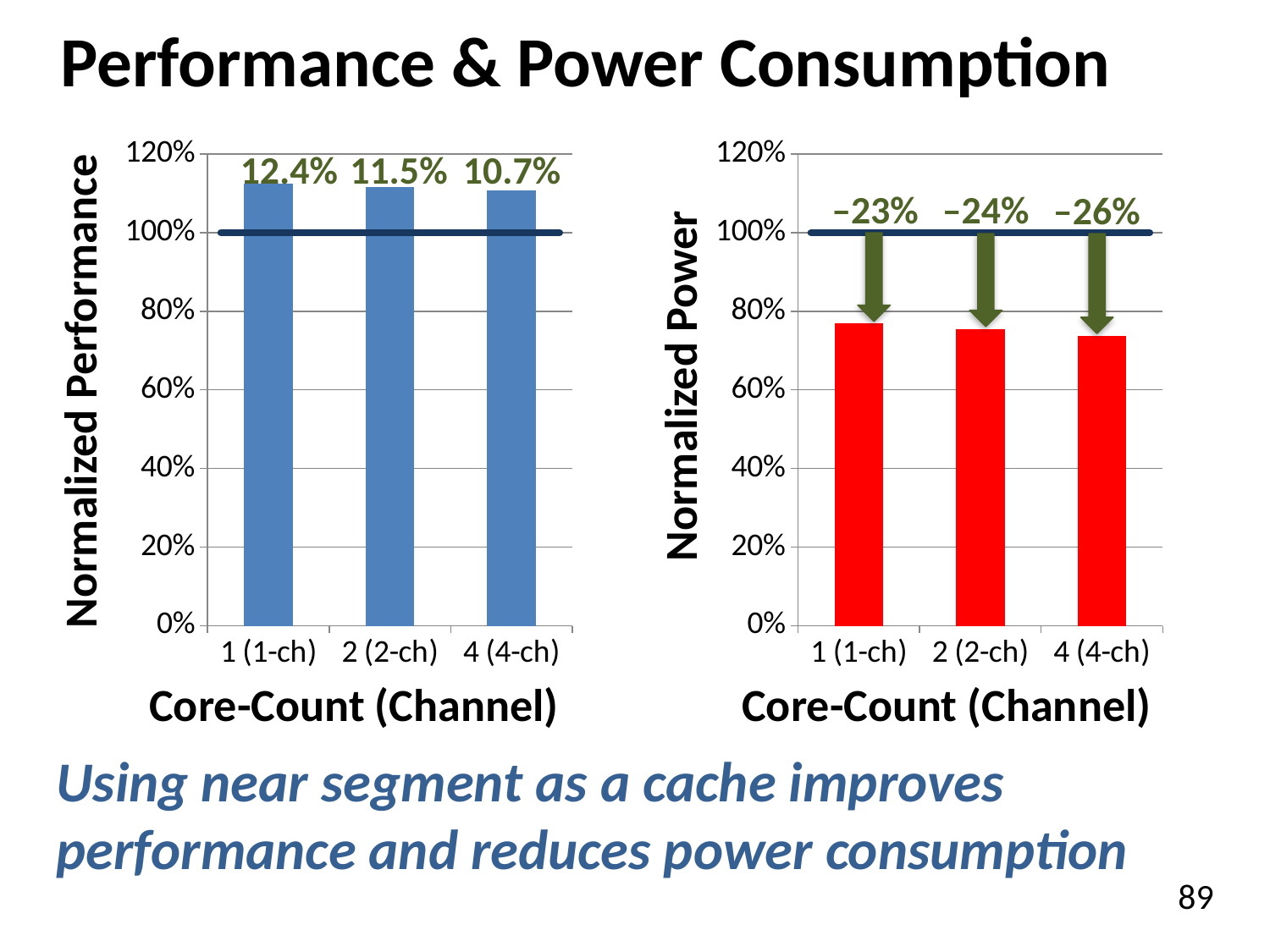
In the left chart (Normalized Performance), how many core-count configurations are plotted? 3 In the right chart (Normalized Power), what power reduction is annotated for 2 (2-ch)? –24% In the right chart (Normalized Power), which core-count configuration has the largest annotated power reduction? 4 (4-ch) In the right chart (Normalized Power), what power reduction is annotated for 4 (4-ch)? –26% In the right chart (Normalized Power), is the value for 1 (1-ch) greater or less than 80%? less In the left chart (Normalized Performance), what performance improvement is annotated above the bar for 4 (4-ch)? 10.7% In the left chart (Normalized Performance), what performance improvement is annotated above the bar for 1 (1-ch)? 12.4% In the left chart (Normalized Performance), which core-count configuration has the largest annotated performance improvement? 1 (1-ch) What kind of chart is the right chart (Normalized Power)? bar chart In the right chart (Normalized Power), do the bar values rise or fall as core-count increases from 1 (1-ch) to 4 (4-ch)? fall What is the x-axis title of the left chart (Normalized Performance)? Core-Count (Channel) In the left chart (Normalized Performance), is the value for 2 (2-ch) greater or less than 100%? greater